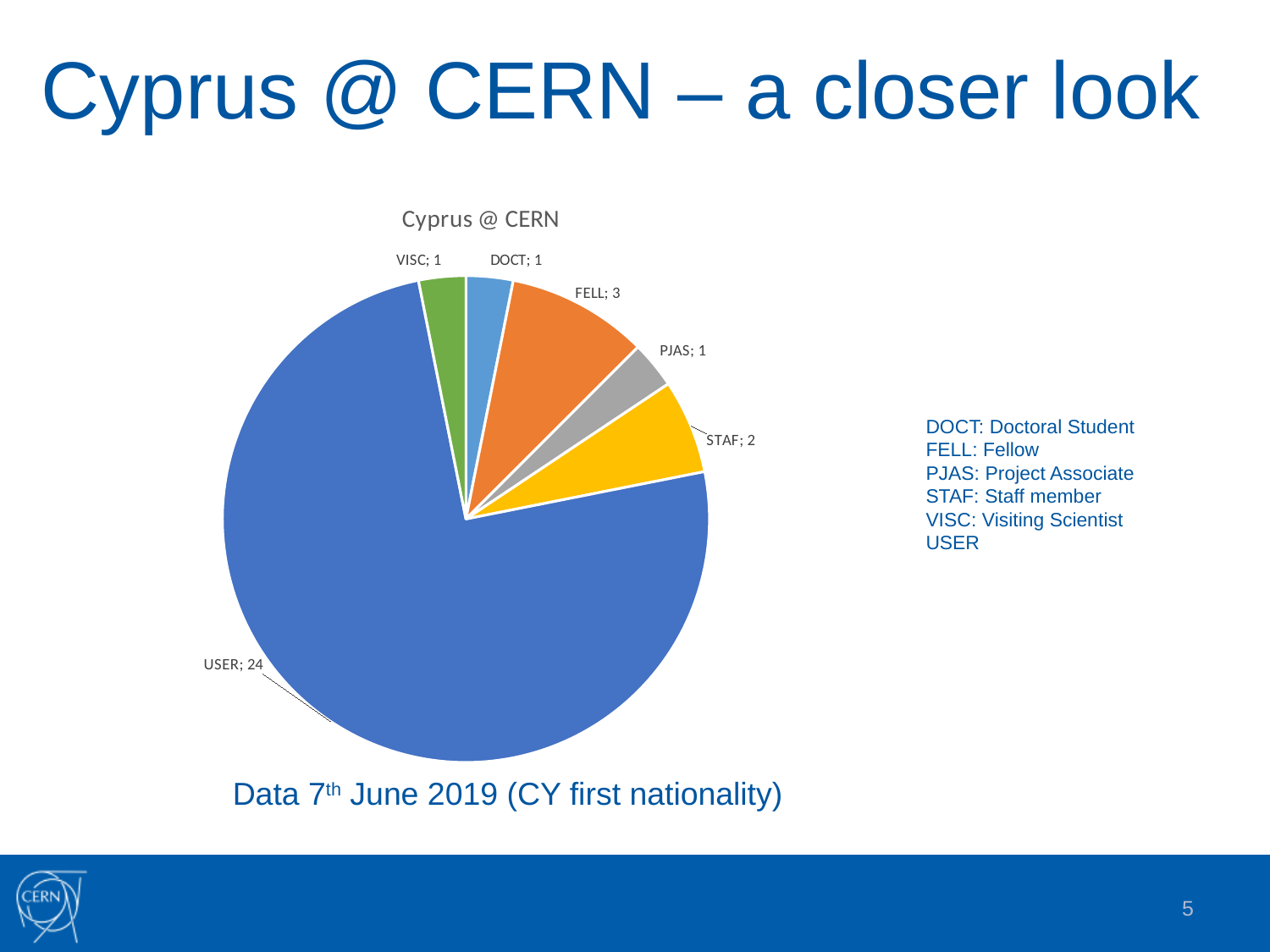
What kind of chart is shown on the slide? pie chart What is the difference between the values for USER and FELL? 21 What is the value for USER in the pie chart? 24 What share of the pie does the USER slice represent? 75% Which category has the largest slice of the pie chart? USER What is the value for STAF in the pie chart? 2 What is the title of the pie chart? Cyprus @ CERN How many categories are shown in the pie chart? 6 What is the value for VISC in the pie chart? 1 What is the value for FELL in the pie chart? 3 What is the difference between the values for FELL and STAF? 1 Which is larger, the value for FELL or the value for STAF? FELL